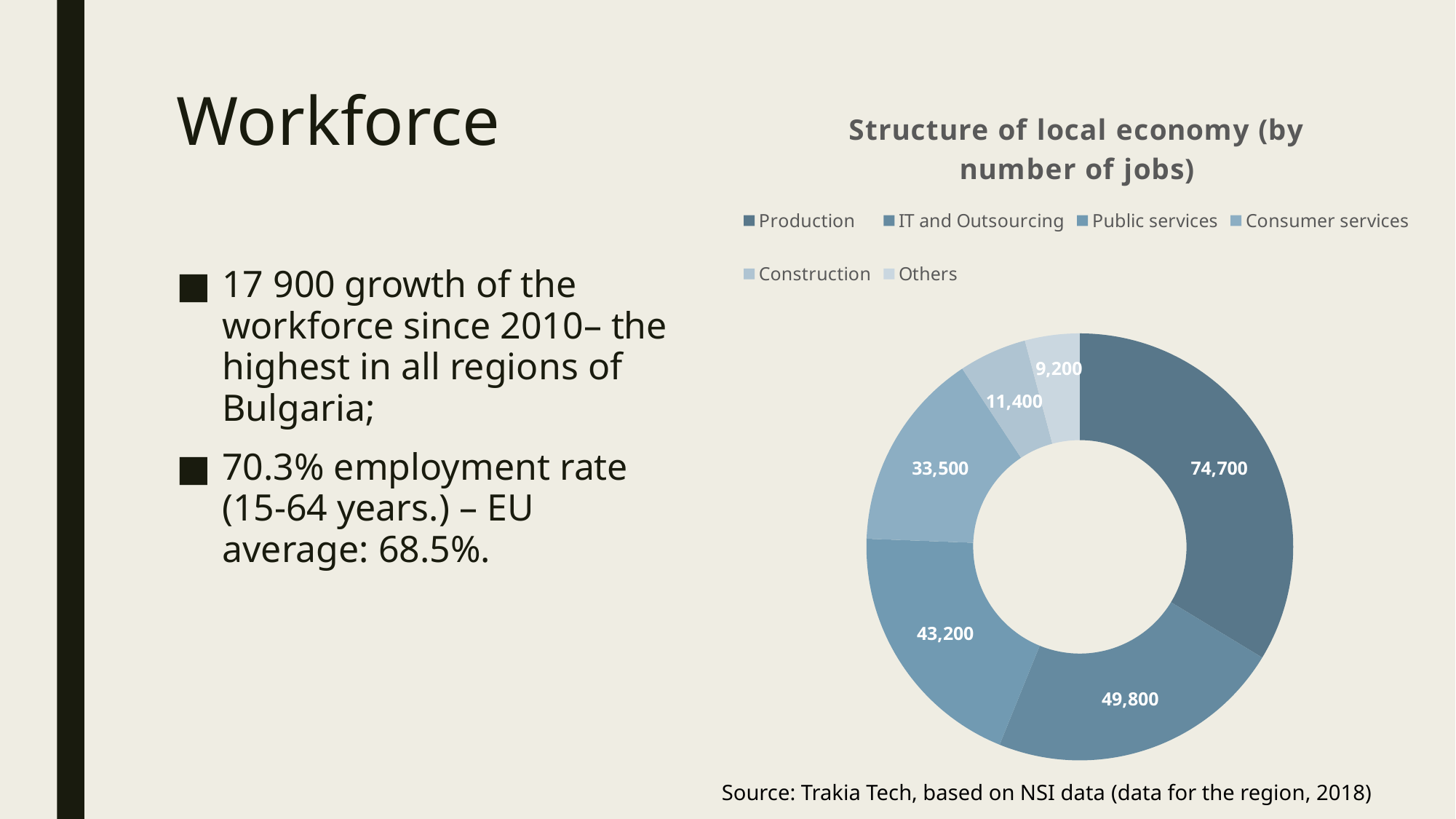
What is the number of jobs for Public services? 43,200 What is the difference in jobs between Production and IT and Outsourcing? 24,900 How many categories does the chart's legend list? 6 Which category has the smallest number of jobs? Others What is the title of the chart? Structure of local economy (by number of jobs) What is the number of jobs for Production? 74,700 What is the total number of jobs across all categories in the chart? 221,800 What type of chart is shown on the slide? Doughnut (pie) chart Which category has the largest number of jobs? Production What is the number of jobs for Construction? 11,400 Which has more jobs, Public services or Consumer services? Public services What is the number of jobs for IT and Outsourcing? 49,800